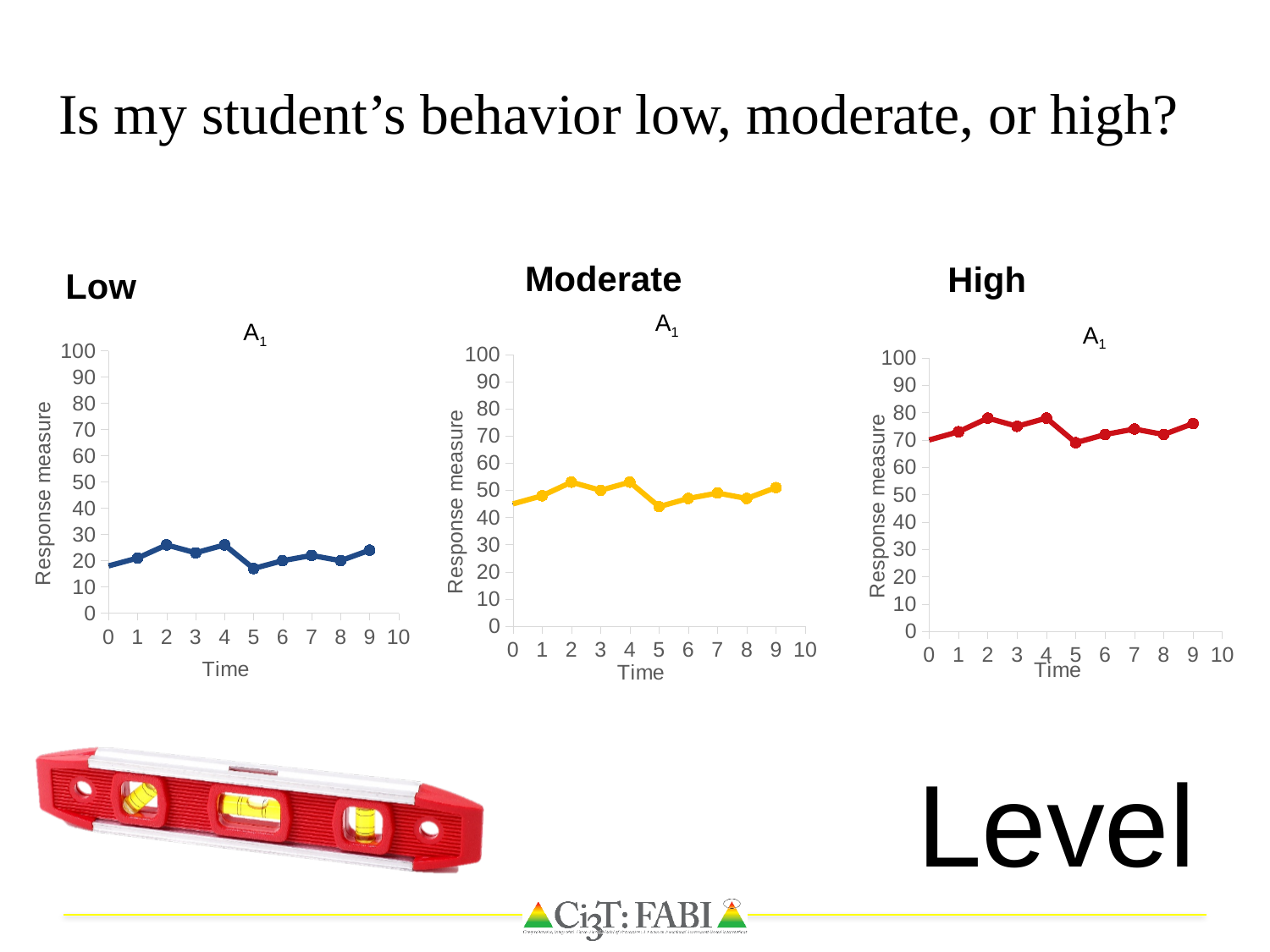
On the Moderate chart, is the value at time 5 greater or less than 50? less On the Moderate chart, is the value at time 0 greater or less than 60? less What is the label on the y axis of the Low chart? Response measure On the High chart, is the value at time 0 greater or less than 60? greater How many data points are plotted on the Moderate chart? 10 What kind of chart is the Low chart? line chart What colour is the line on the High chart? red How many data points are plotted on the High chart? 10